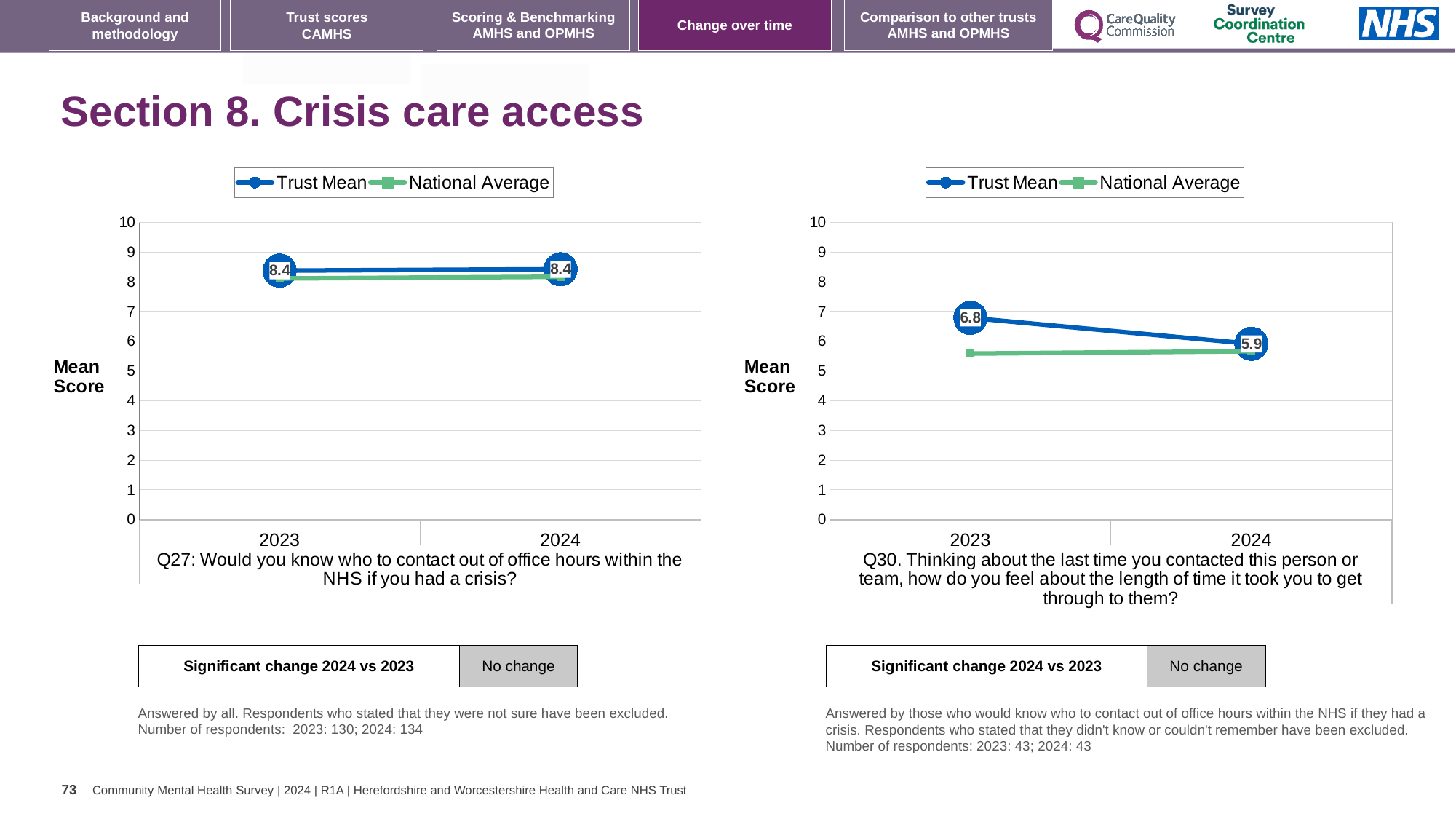
How many series does the legend of the Q27 chart (left) list? 2 On the Q27 chart (left), is the National Average for 2023 greater or less than 7? greater On the Q27 chart (left), what is the Trust Mean score for 2023? 8.4 On the Q30 chart (right), what is the Trust Mean score for 2023? 6.8 What kind of chart is the Q27 chart (left)? line chart On the Q30 chart (right), what is the Trust Mean score for 2024? 5.9 On the Q30 chart (right), which year has the higher Trust Mean, 2023 or 2024? 2023 On the Q30 chart (right), is the National Average for 2023 greater or less than 6? less How many years are plotted on the x axis of the Q30 chart (right)? 2 On the Q27 chart (left), what is the Trust Mean score for 2024? 8.4 On the Q30 chart (right), does the Trust Mean rise or fall from 2023 to 2024? fall On the Q30 chart (right), by how much did the Trust Mean fall from 2023 to 2024? 0.9